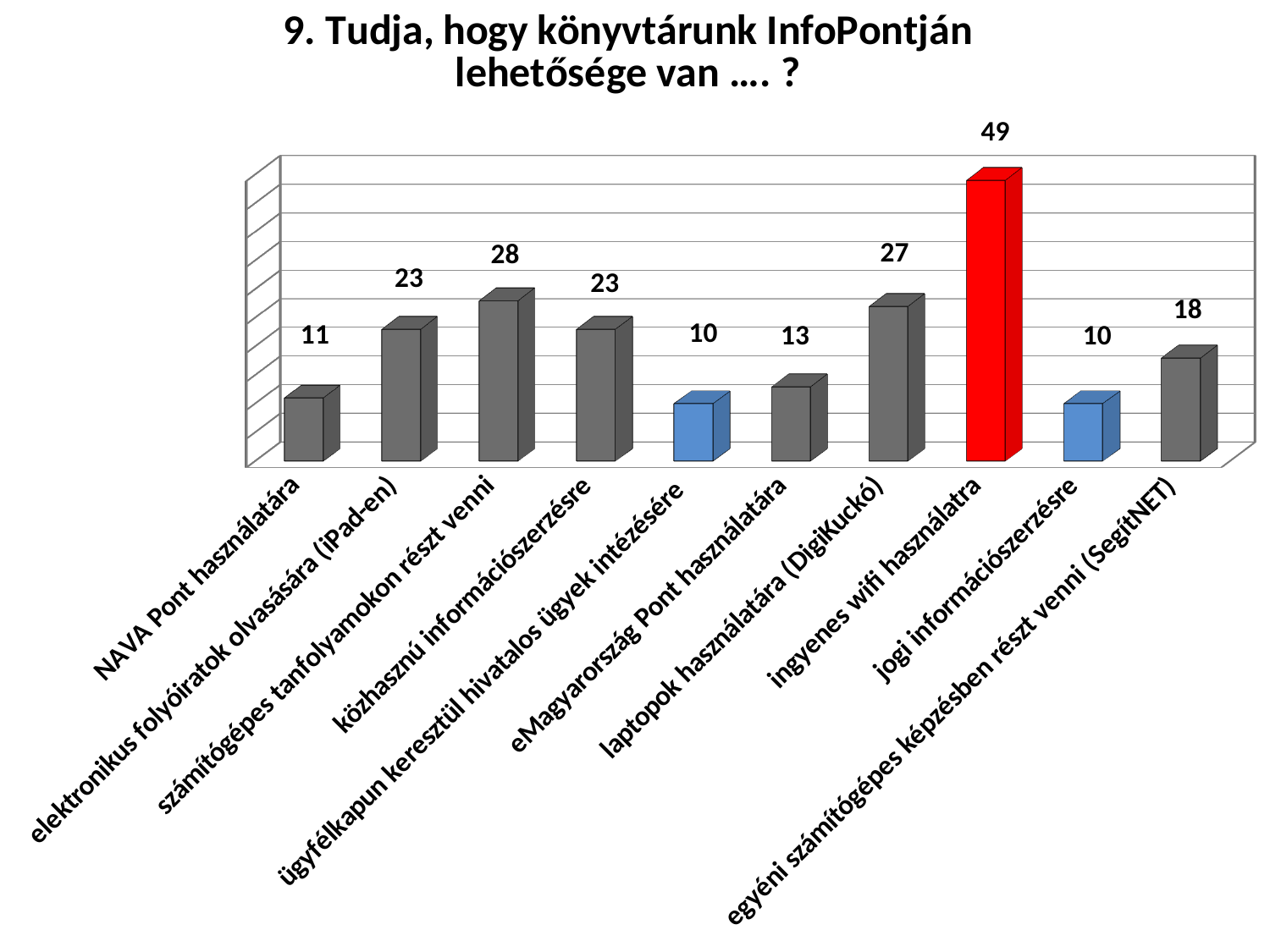
How many categories are shown in the chart? 10 What is the difference between the values for "laptopok használatára (DigiKuckó)" and "eMagyarország Pont használatára"? 14 What kind of chart is shown on the slide? bar chart What value is shown for "laptopok használatára (DigiKuckó)"? 27 What is the difference between the values for "ingyenes wifi használatra" and "számítógépes tanfolyamokon részt venni"? 21 What value is shown for "egyéni számítógépes képzésben részt venni (SegítNET)"? 18 Which is larger, the value for "számítógépes tanfolyamokon részt venni" or the value for "közhasznú információszerzésre"? számítógépes tanfolyamokon részt venni What value is shown for "ingyenes wifi használatra"? 49 How many bars are coloured blue? 2 What colour is the bar for "ingyenes wifi használatra"? red Which category has the highest value? ingyenes wifi használatra What value is shown for "NAVA Pont használatára"? 11